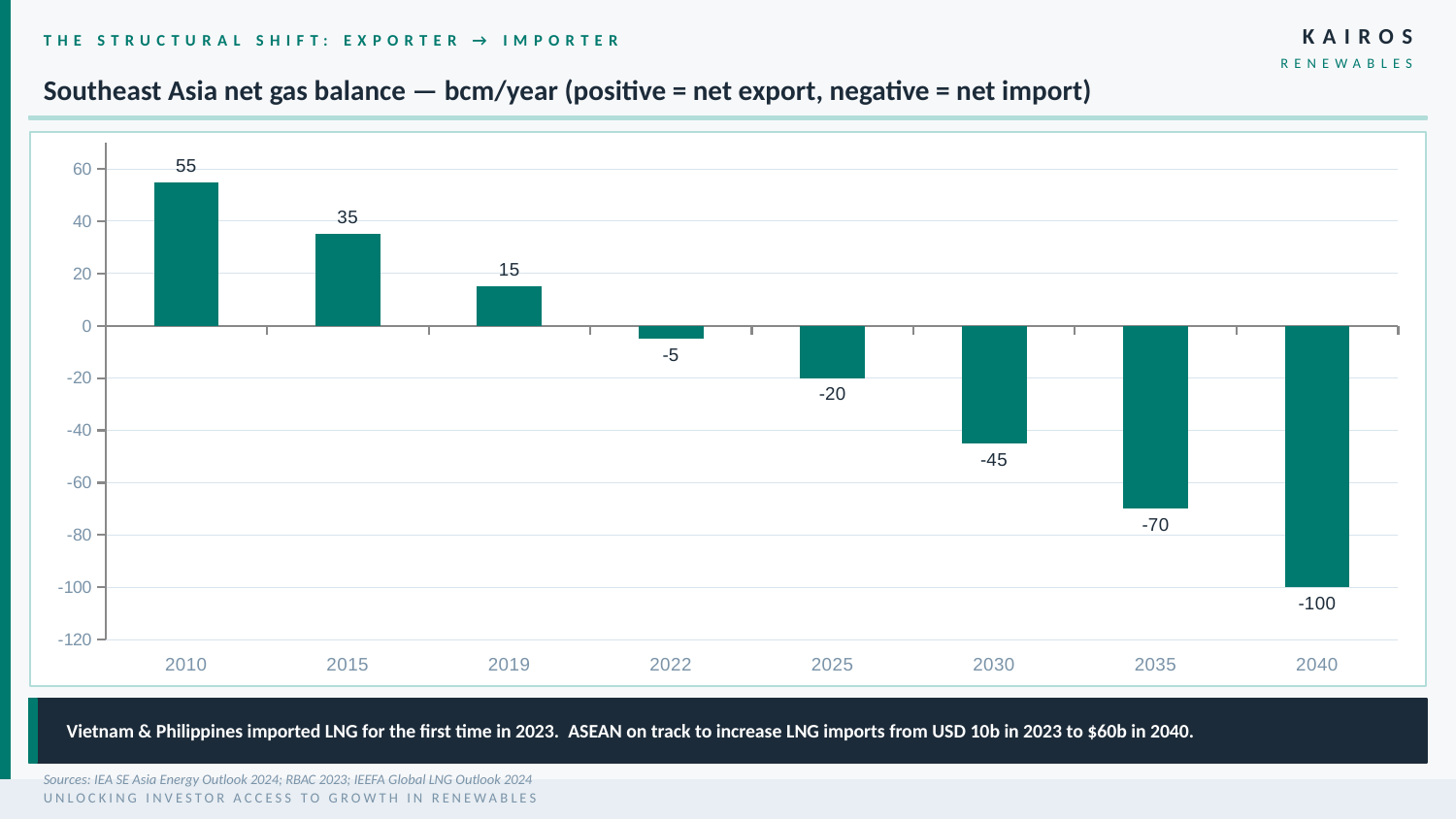
Do the values rise or fall from 2010 to 2040? Fall Which year has the lowest net gas balance? 2040 Which is larger, the value for 2015 or the value for 2019? 2015 What is the title of the chart? Southeast Asia net gas balance — bcm/year (positive = net export, negative = net import) What is the net gas balance value for 2022? -5 How many years are shown on the x axis? 8 What is the difference between the values for 2010 and 2019? 40 What is the net gas balance value for 2010? 55 What is the net gas balance value for 2030? -45 Which year has the highest net gas balance? 2010 What kind of chart is shown on the slide? Bar chart What is the difference between the values for 2025 and 2040? 80